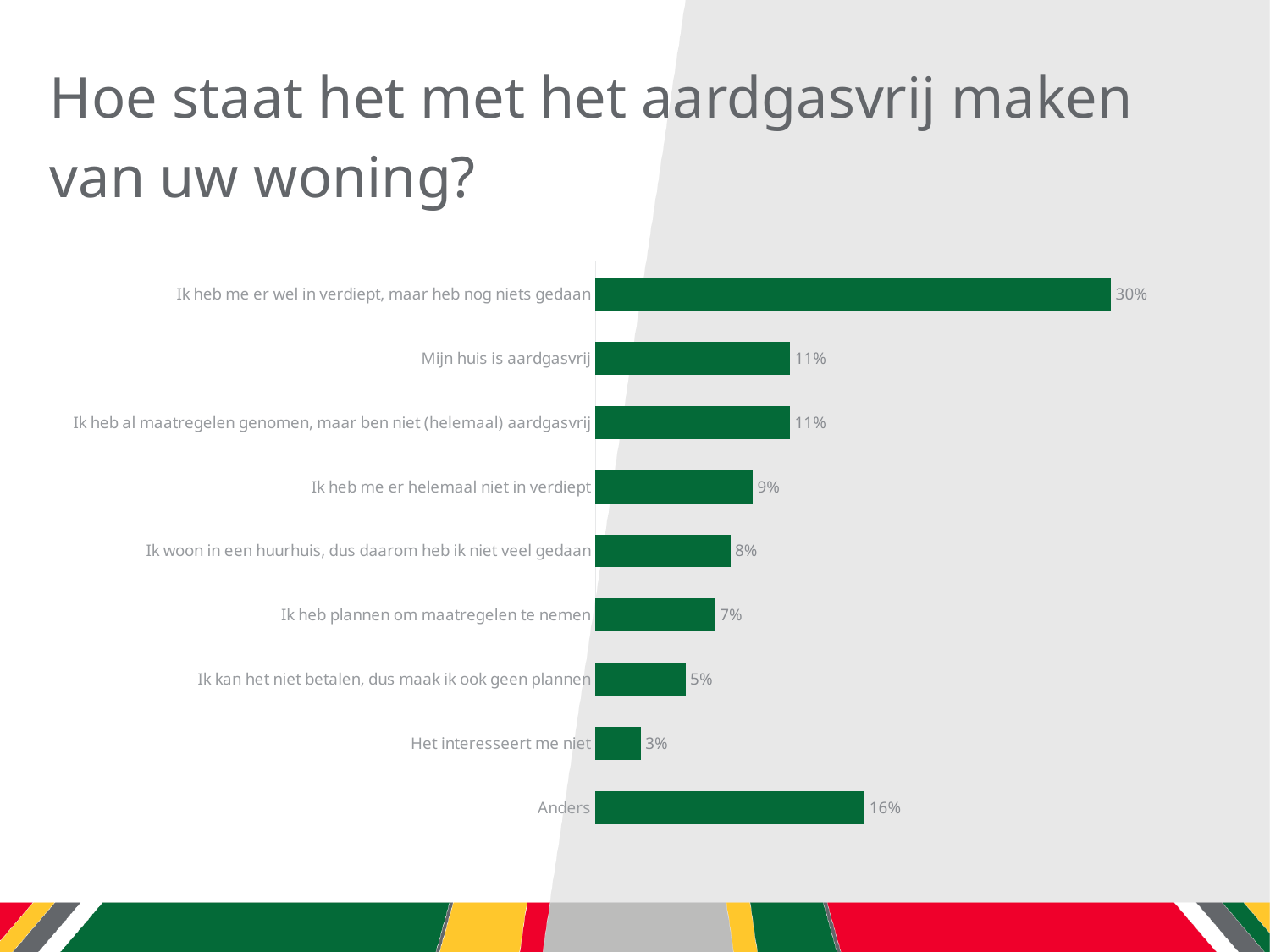
What is the value for "Anders"? 16% How many categories are shown in the chart? 9 Which category has the lowest value? Het interesseert me niet What is the difference between the values for "Ik heb me er wel in verdiept, maar heb nog niets gedaan" and "Anders"? 14% What colour are the bars in the chart? Green What is the value for "Ik woon in een huurhuis, dus daarom heb ik niet veel gedaan"? 8% What kind of chart is shown on the slide? Bar chart What is the difference between the values for "Ik kan het niet betalen, dus maak ik ook geen plannen" and "Het interesseert me niet"? 2% Which is larger: the value for "Ik heb me er helemaal niet in verdiept" or the value for "Ik heb plannen om maatregelen te nemen"? Ik heb me er helemaal niet in verdiept What is the value for "Mijn huis is aardgasvrij"? 11% Which category has the highest value? Ik heb me er wel in verdiept, maar heb nog niets gedaan What is the title of the slide containing the chart? Hoe staat het met het aardgasvrij maken van uw woning?